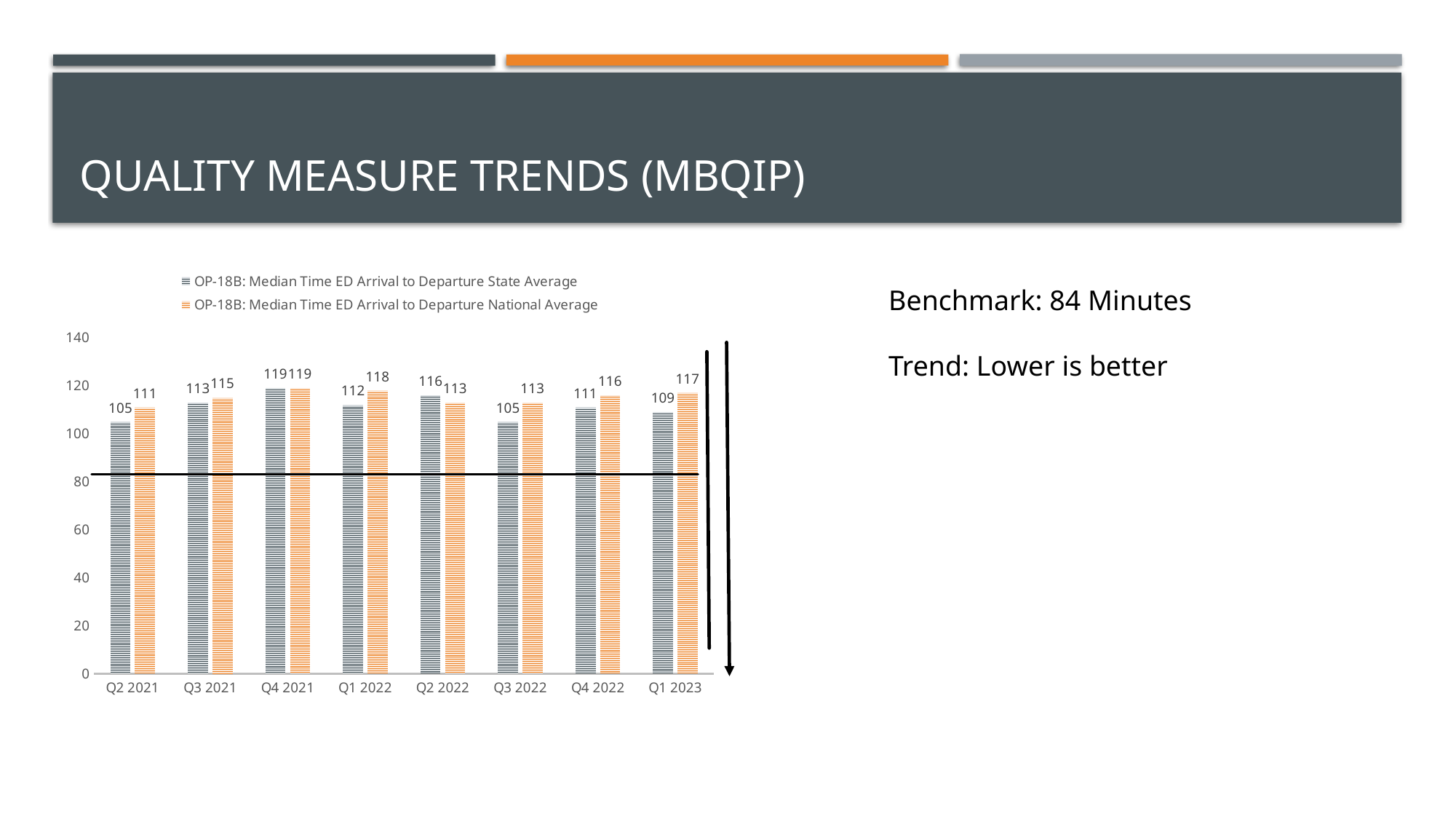
What is the difference between the National Average and the State Average in Q3 2022? 8 How many quarters are shown on the x axis? 8 In which quarter is the State Average highest? Q4 2021 What is the State Average value for Q2 2021? 105 What is the State Average value for Q2 2022? 116 In Q2 2022, which is larger: the State Average or the National Average? State Average What benchmark value is stated on the slide? 84 Minutes In which quarter is the National Average lowest? Q2 2021 What kind of chart is shown on the slide? Bar chart Is the State Average value for Q1 2023 greater or less than 100? greater What is the National Average value for Q1 2023? 117 How many series does the legend list? 2